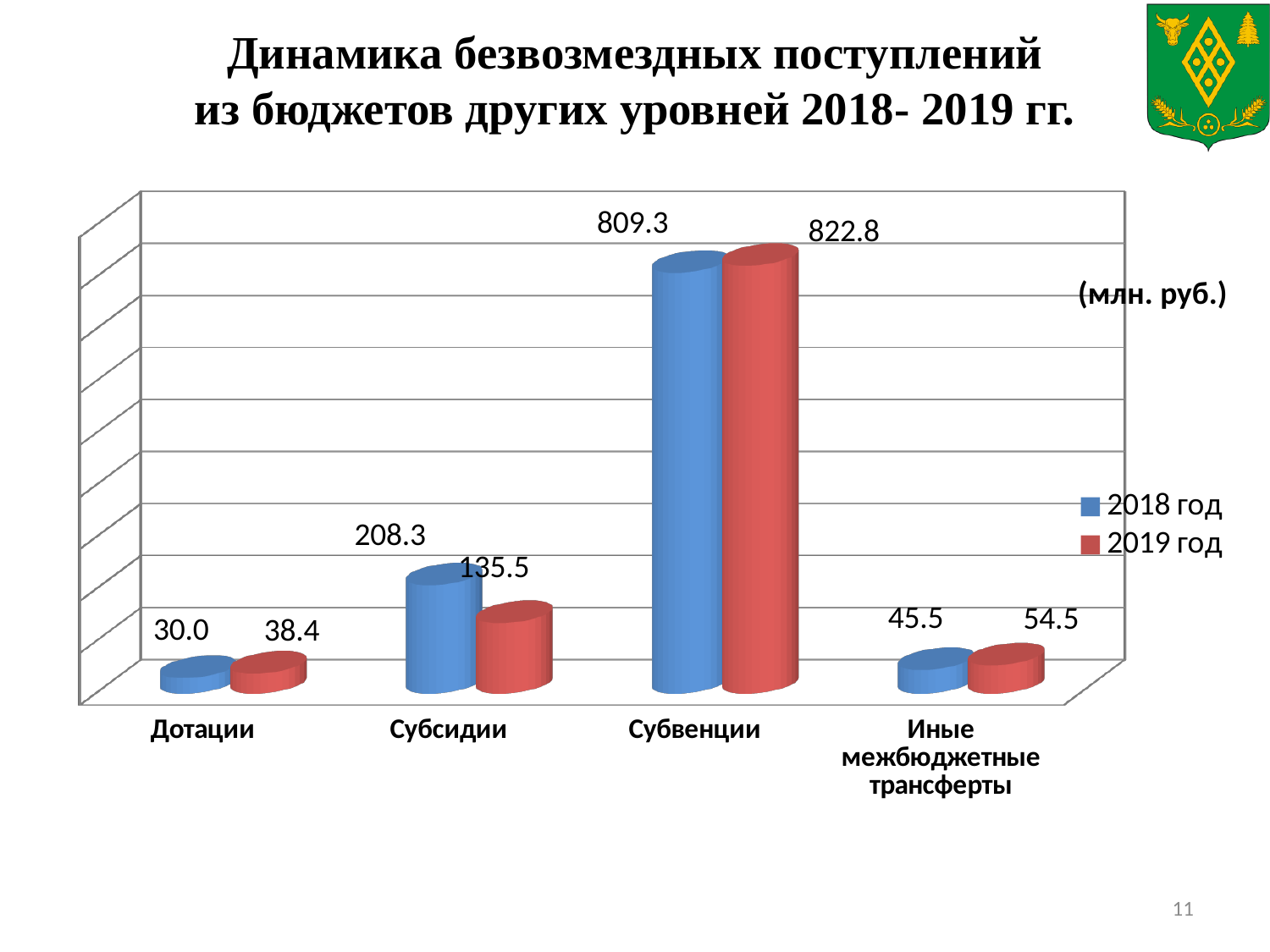
What is the value for Дотации in 2018 год? 30.0 What is the difference between the 2019 год and 2018 год values for Субвенции? 13.5 What is the value for Субсидии in 2019 год? 135.5 How many series does the legend list? 2 What kind of chart is shown on the slide? bar chart Which is larger for Дотации: the 2018 год value or the 2019 год value? 2019 год What is the difference between the 2018 год and 2019 год values for Субсидии? 72.8 Which category has the lowest value in 2018 год? Дотации What is the value for Иные межбюджетные трансферты in 2019 год? 54.5 What is the value for Субвенции in 2018 год? 809.3 Which category has the highest value in 2019 год? Субвенции How many categories are shown on the x axis? 4